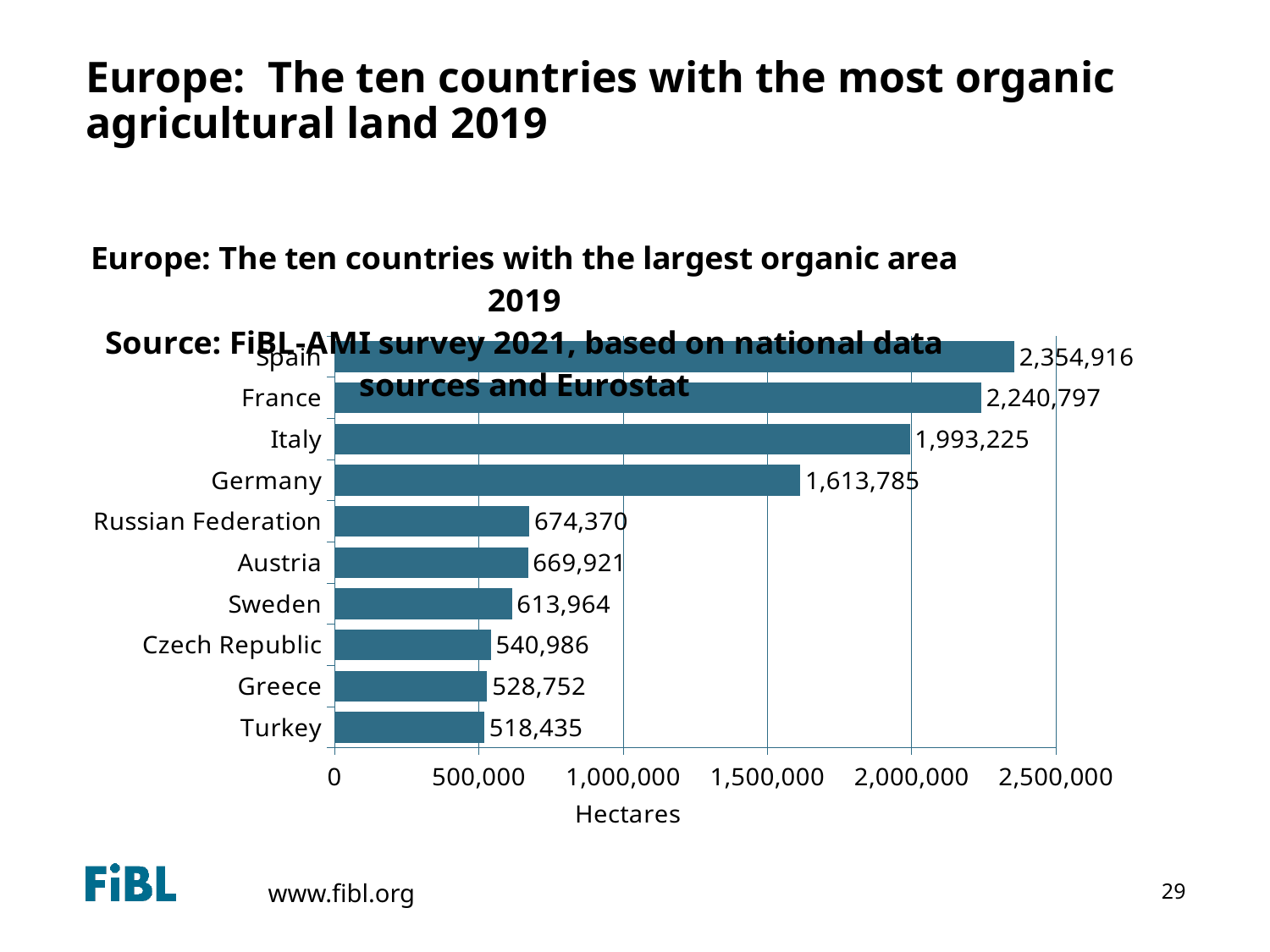
What is the value shown for the Czech Republic? 540,986 What is the difference between the values for Greece and Turkey? 10,317 Which country has the largest organic area in the chart? Spain What is the difference between the values for Spain and France? 114,119 What is the organic agricultural area for Spain in hectares? 2,354,916 What unit is shown on the horizontal axis of the chart? Hectares Is the value for Germany greater or less than 1,500,000? greater How many countries are shown in the chart? 10 Which has a larger organic area, Italy or Germany? Italy What is the value shown for Germany? 1,613,785 Which country has the smallest organic area in the chart? Turkey What type of chart is shown on the slide? bar chart